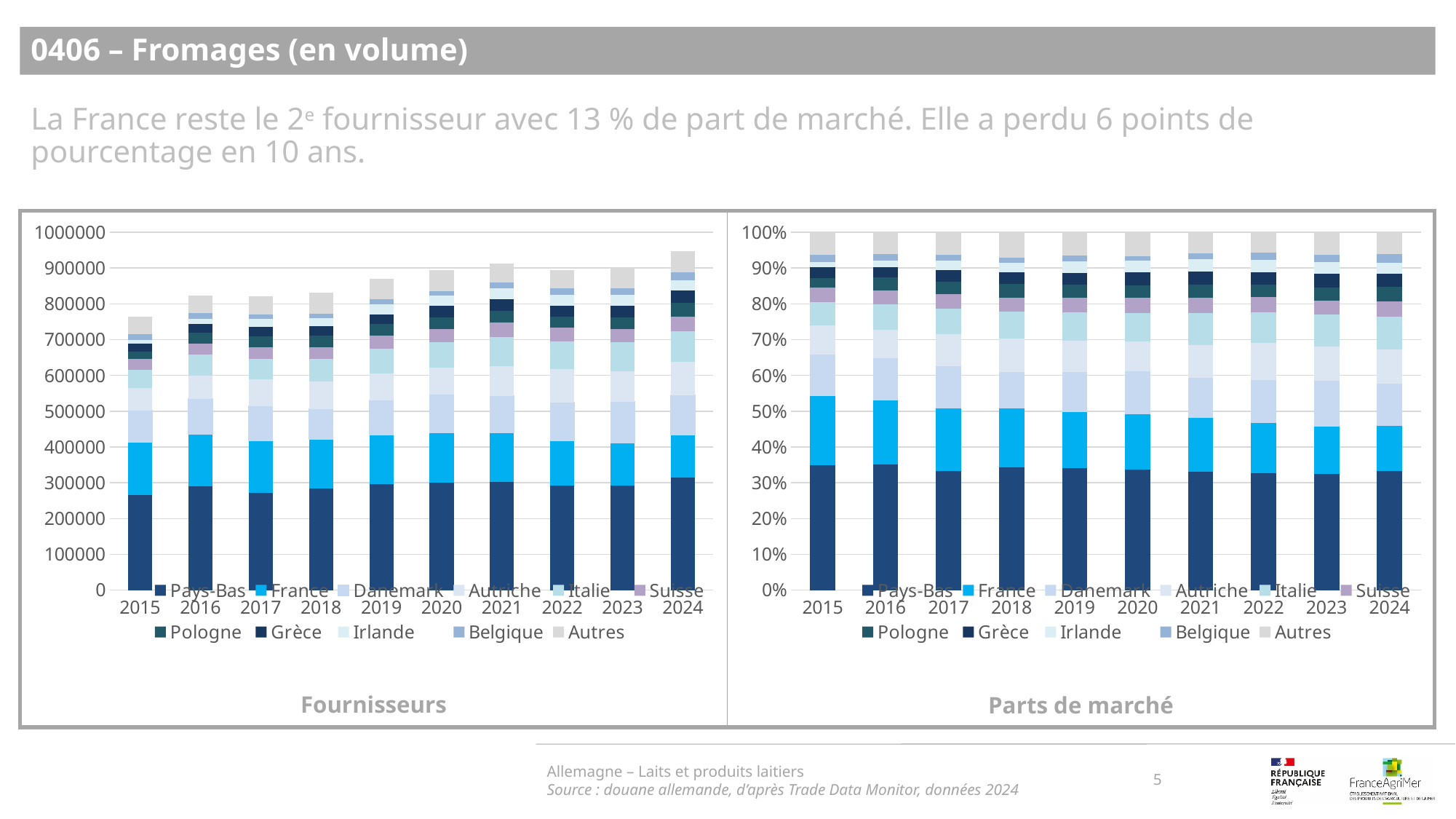
In the 'Parts de marché' chart, does the share of France rise or fall from 2015 to 2024? fall In the 'Fournisseurs' chart, is the Pays-Bas value for 2024 greater or less than 300000? greater Which series is at the bottom of each stacked bar in the 'Parts de marché' chart? Pays-Bas How many years are shown on the x axis of the 'Parts de marché' chart? 10 In the 'Fournisseurs' chart, is the total bar for 2015 greater or less than 800000? less In the 'Fournisseurs' chart, is the total bar for 2024 greater or less than 900000? greater In the 'Fournisseurs' chart, which year has the lowest total bar? 2015 What kind of chart is the 'Fournisseurs' chart on the left? Stacked bar chart What is the title of the chart on the right of the slide? Parts de marché How many series does the legend of the 'Fournisseurs' chart list? 11 In the 'Fournisseurs' chart, is the total bar larger in 2024 or in 2015? 2024 In the 'Fournisseurs' chart, which year has the highest total bar? 2024